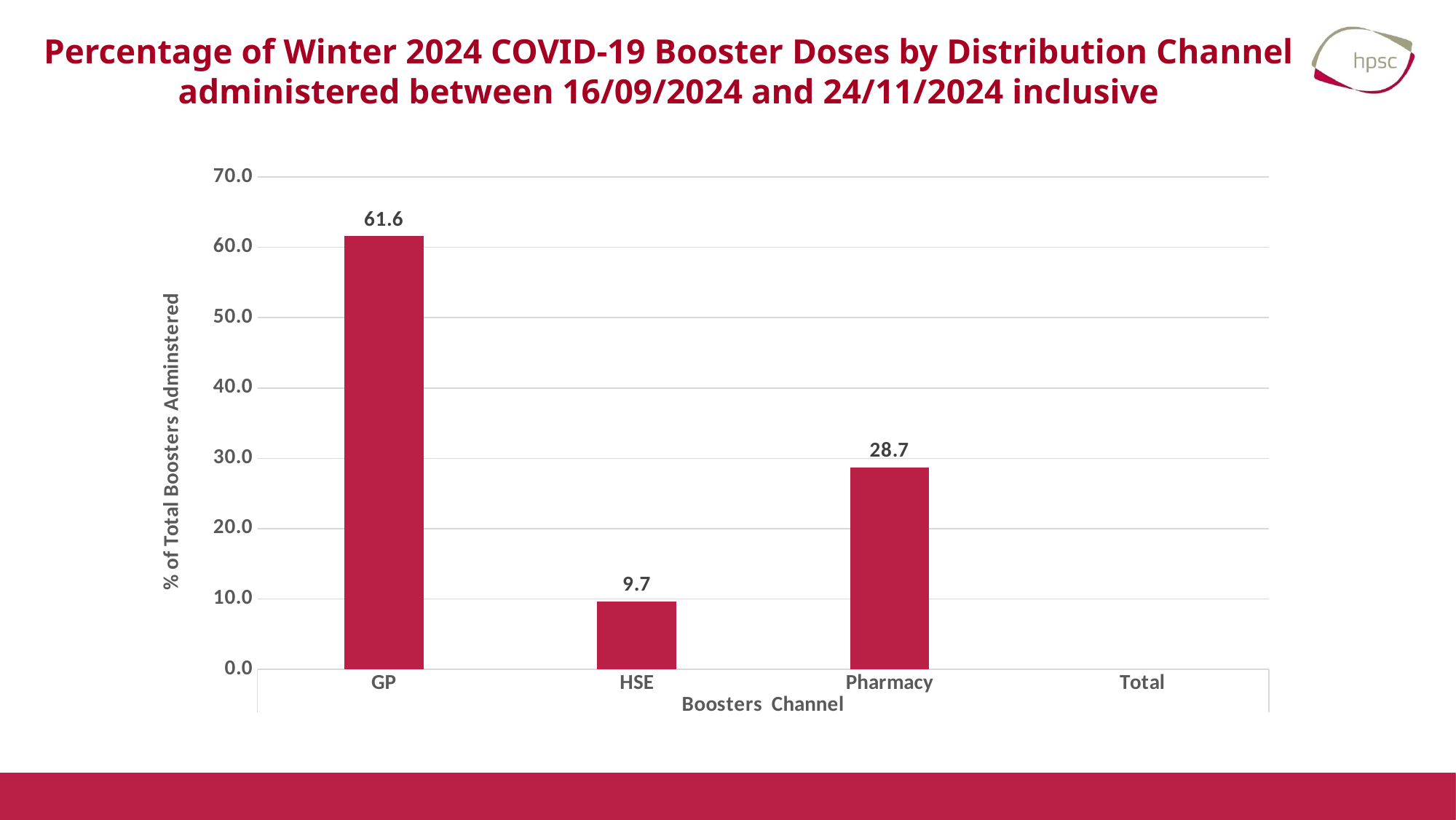
Which distribution channel has the highest percentage of boosters administered? GP Which channel has a larger percentage, HSE or Pharmacy? Pharmacy Which distribution channel has the lowest percentage of boosters administered among the plotted bars? HSE How many bars are plotted in the chart? 3 What percentage of total boosters was administered through the GP channel? 61.6 What percentage of total boosters was administered through the HSE channel? 9.7 What type of chart is shown on the slide? bar chart What is the label of the y axis? % of Total Boosters Adminstered What is the difference in percentage points between the Pharmacy and HSE channels? 19.0 What percentage of total boosters was administered through the Pharmacy channel? 28.7 What is the difference in percentage points between the GP and Pharmacy channels? 32.9 Is the value for GP greater or less than 60.0? greater